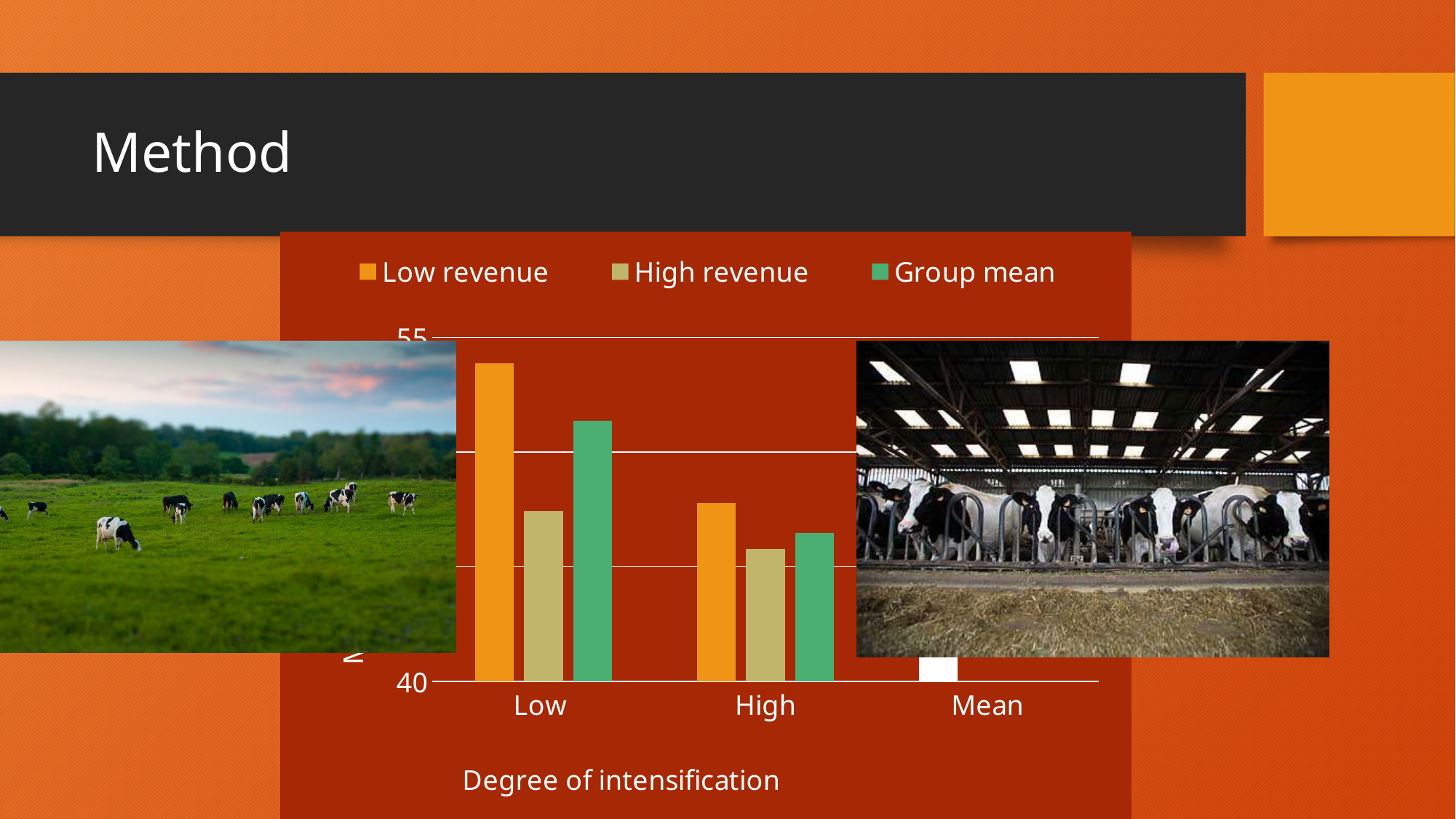
What is the highest value labelled on the y axis? 55 In the Low category, which series has the tallest bar? Low revenue Does the Low revenue series rise or fall from Low to High? fall Which is larger: the Low revenue value for Low or the Low revenue value for High? Low In the High category, which series has the shortest bar? High revenue What kind of chart is shown on the slide? bar chart Which is larger in the Low category: the High revenue bar or the Group mean bar? Group mean Which series are listed in the legend? Low revenue, High revenue, Group mean Is the Low revenue value for Low greater or less than 55? less What is the title of the x axis? Degree of intensification How many series does the legend list? 3 How many categories are shown on the x axis? 3